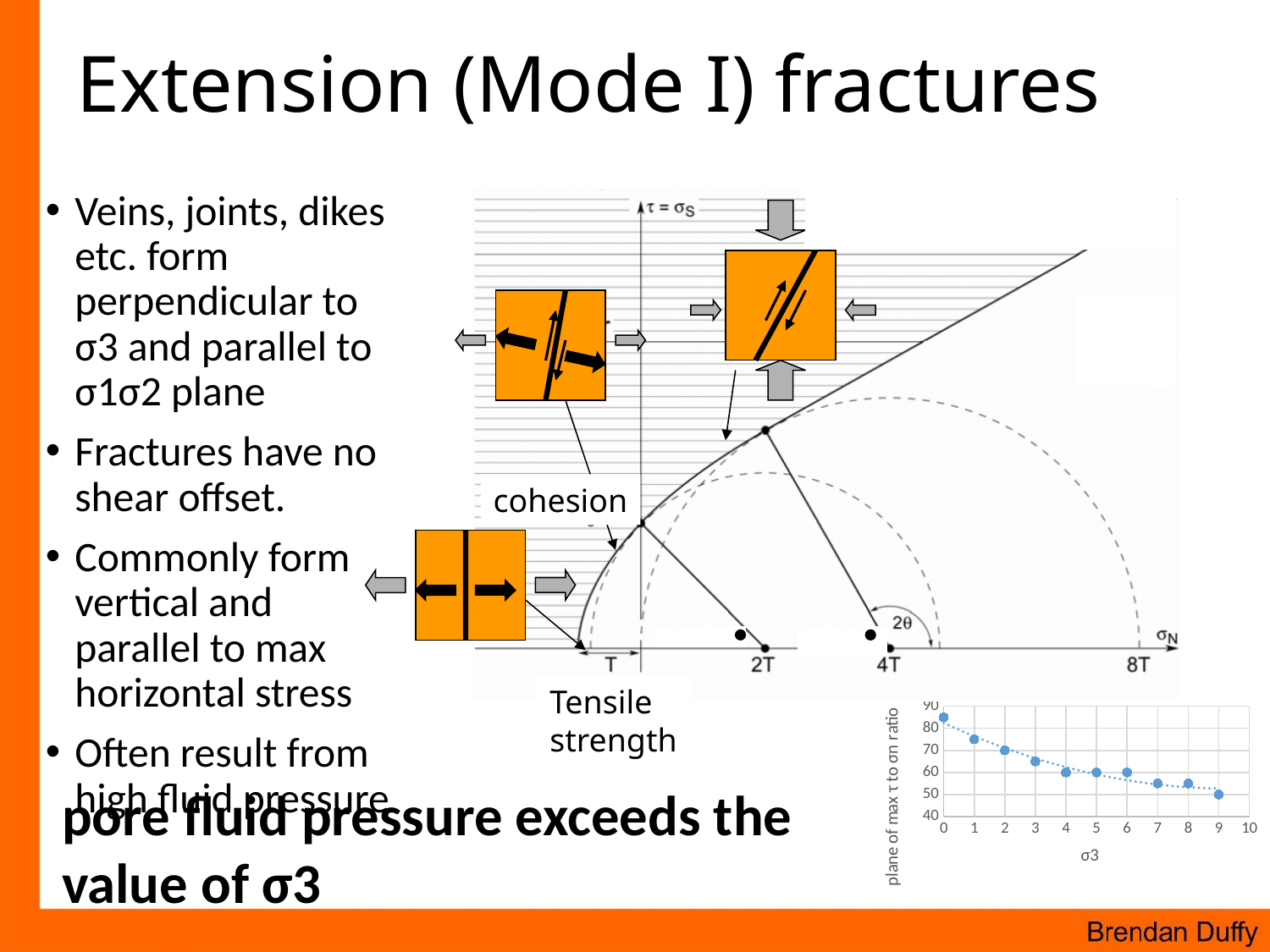
In the bottom-right chart, do the values rise or fall as σ3 increases? fall In the bottom-right chart, at which σ3 value is the plotted ratio lowest? 9 What is the label on the y axis of the bottom-right chart? plane of max τ to σn ratio In the bottom-right chart, is the value at σ3 = 3 greater or less than 70? less In the bottom-right chart, is the value at σ3 = 1 greater or less than 70? greater How many data points are plotted in the bottom-right chart? 10 What is the label on the x axis of the bottom-right chart? σ3 In the bottom-right chart, is the value at σ3 = 0 greater or less than 80? greater What kind of chart is shown at the bottom right of the slide? scatter chart In the bottom-right chart, which has the larger value: σ3 = 1 or σ3 = 8? σ3 = 1 In the bottom-right chart, at which σ3 value is the plotted ratio highest? 0